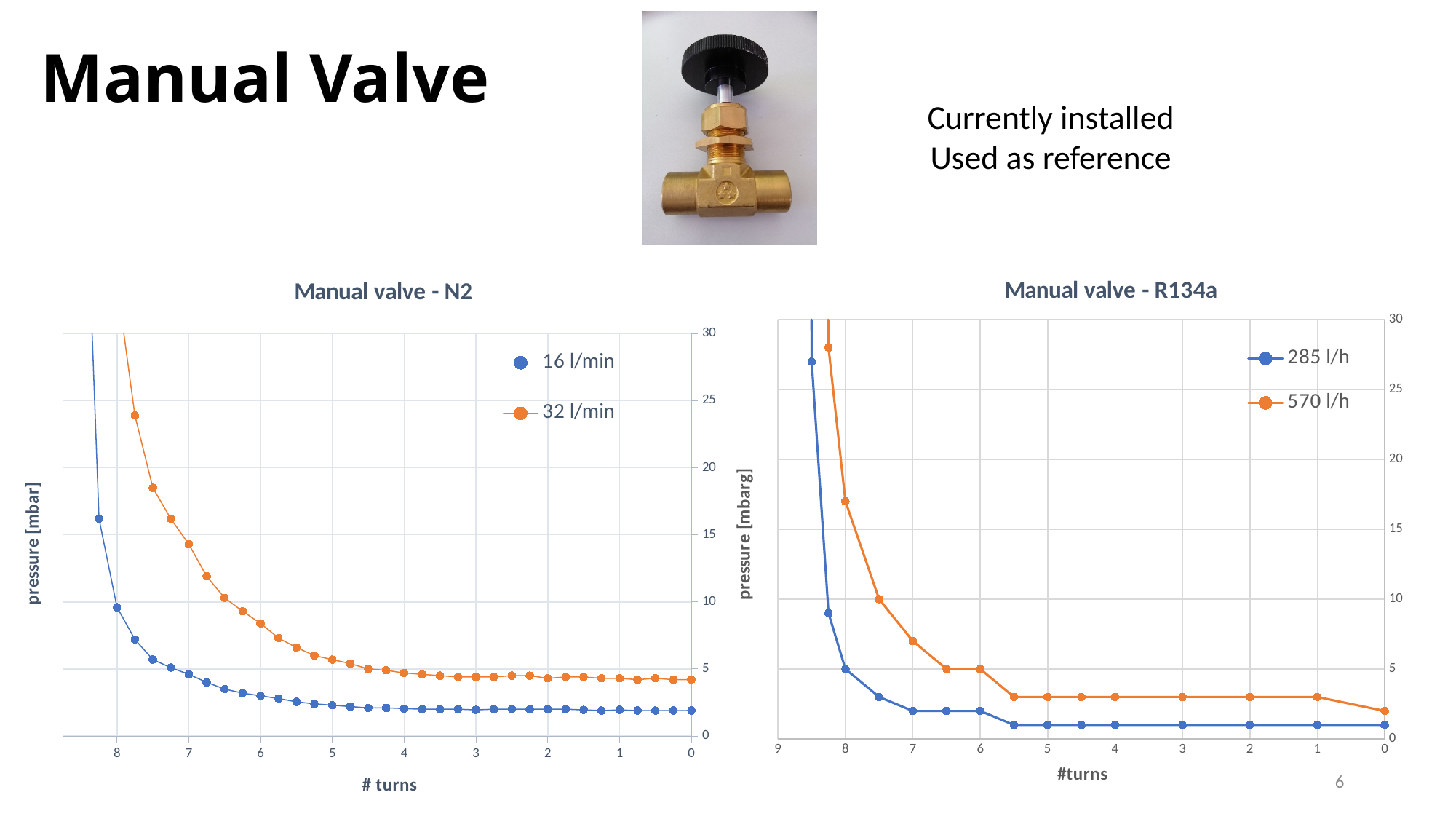
In the 'Manual valve - N2' chart, does the pressure for 32 l/min rise or fall as the number of turns decreases from 8 to 0? fall In the 'Manual valve - R134a' chart, which series has the higher pressure at 5 turns, 285 l/h or 570 l/h? 570 l/h How many series does the legend of the 'Manual valve - R134a' chart list? 2 In the 'Manual valve - N2' chart, is the value for 32 l/min at 8 turns greater or less than 20? greater In the 'Manual valve - R134a' chart, is the value for 285 l/h at 7 turns greater or less than 5? less In the 'Manual valve - R134a' chart, is the value for 570 l/h at 7 turns greater or less than 5? greater What is the y-axis label of the 'Manual valve - R134a' chart? pressure [mbarg] In the 'Manual valve - N2' chart, which series has the higher pressure at 6 turns, 16 l/min or 32 l/min? 32 l/min What kind of chart is 'Manual valve - N2'? line chart In the 'Manual valve - N2' chart, which series is listed in the legend besides 16 l/min? 32 l/min